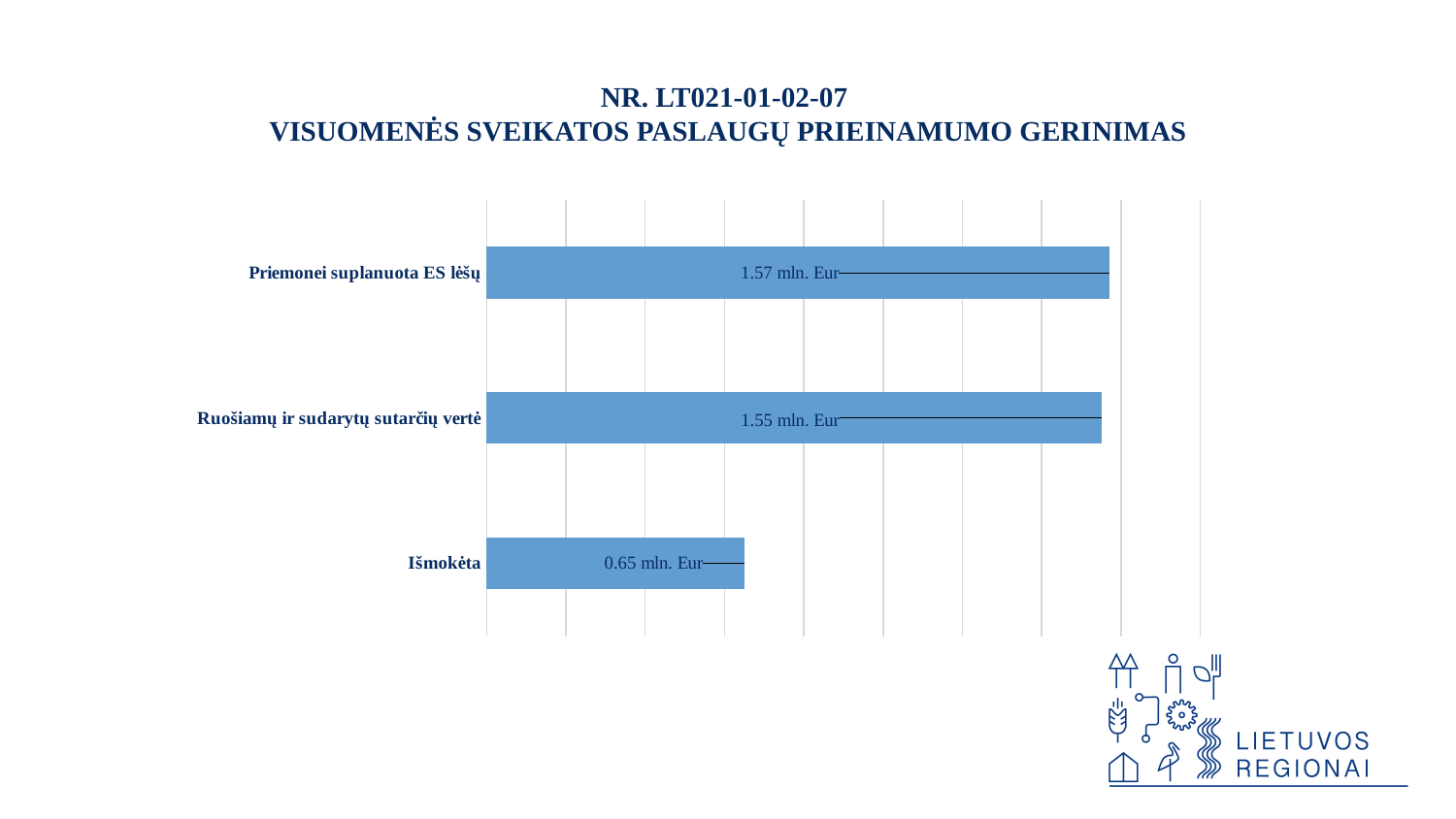
What is the value for "Ruošiamų ir sudarytų sutarčių vertė"? 1.55 mln. Eur What is the project number shown in the slide title? NR. LT021-01-02-07 What is the value for "Išmokėta"? 0.65 mln. Eur What kind of chart is shown on the slide? Bar chart How many categories are shown in the chart? 3 What is the value for "Priemonei suplanuota ES lėšų"? 1.57 mln. Eur What is the difference between "Priemonei suplanuota ES lėšų" and "Ruošiamų ir sudarytų sutarčių vertė"? 0.02 mln. Eur Which category has the lowest value? Išmokėta Which is larger: the value for "Ruošiamų ir sudarytų sutarčių vertė" or the value for "Išmokėta"? Ruošiamų ir sudarytų sutarčių vertė What is the difference between "Ruošiamų ir sudarytų sutarčių vertė" and "Išmokėta"? 0.90 mln. Eur Which category has the highest value? Priemonei suplanuota ES lėšų What is the difference between "Priemonei suplanuota ES lėšų" and "Išmokėta"? 0.92 mln. Eur